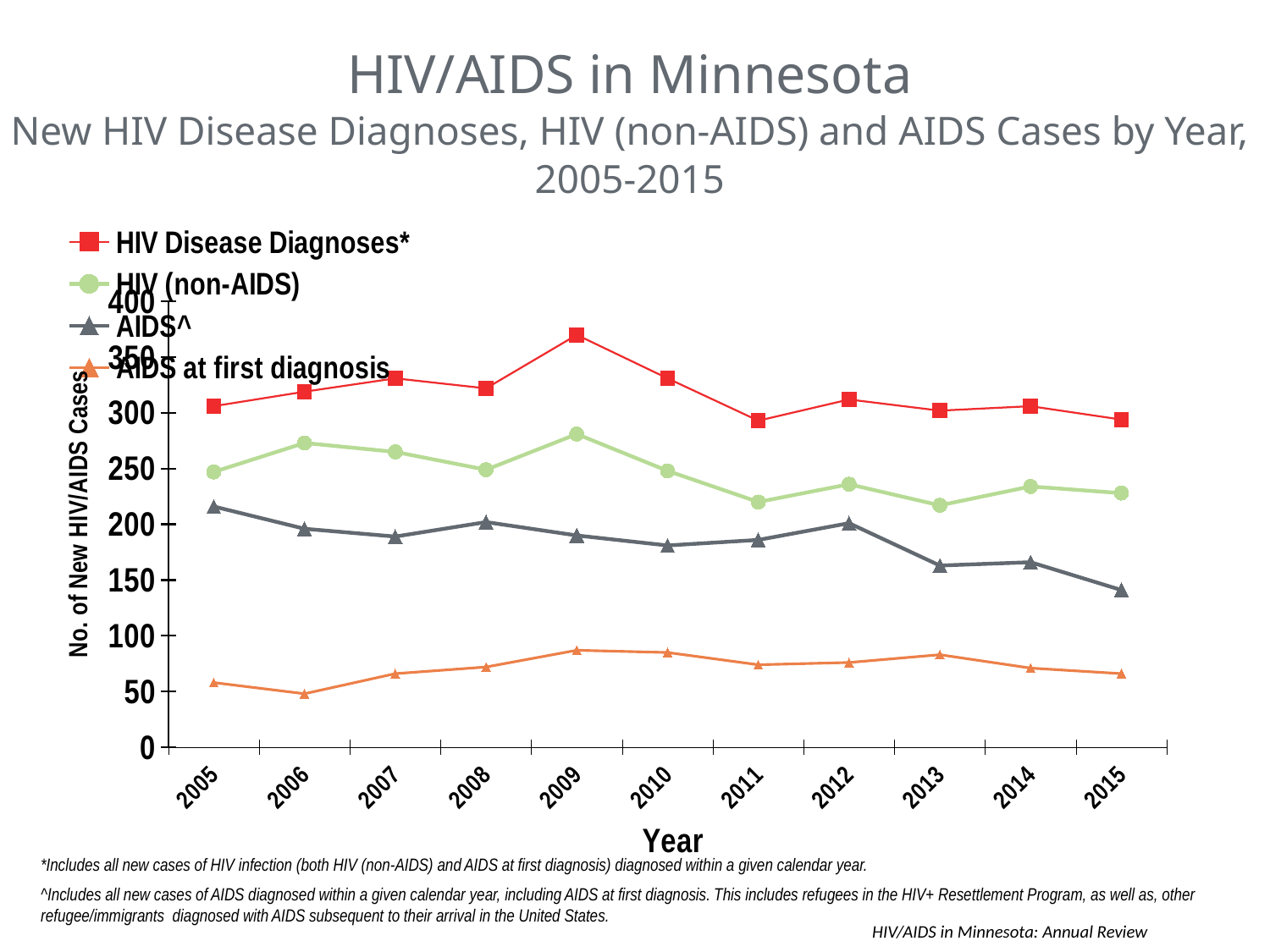
How many series does the legend list? 4 Is the value for AIDS at first diagnosis in 2009 greater or less than 100? less Is the value for HIV (non-AIDS) in 2009 greater or less than 250? greater In which year is the AIDS^ series at its highest? 2005 Is the value for HIV Disease Diagnoses* in 2009 greater or less than 350? greater In which year is the HIV Disease Diagnoses* series at its highest? 2009 In which year is the AIDS^ series at its lowest? 2015 Does the AIDS^ series overall rise or fall from 2005 to 2015? Fall In which year is the AIDS at first diagnosis series at its lowest? 2006 What kind of chart is shown on the slide? Line chart How many years are plotted along the x axis? 11 Which is larger: the AIDS^ value in 2005 or the AIDS^ value in 2015? 2005